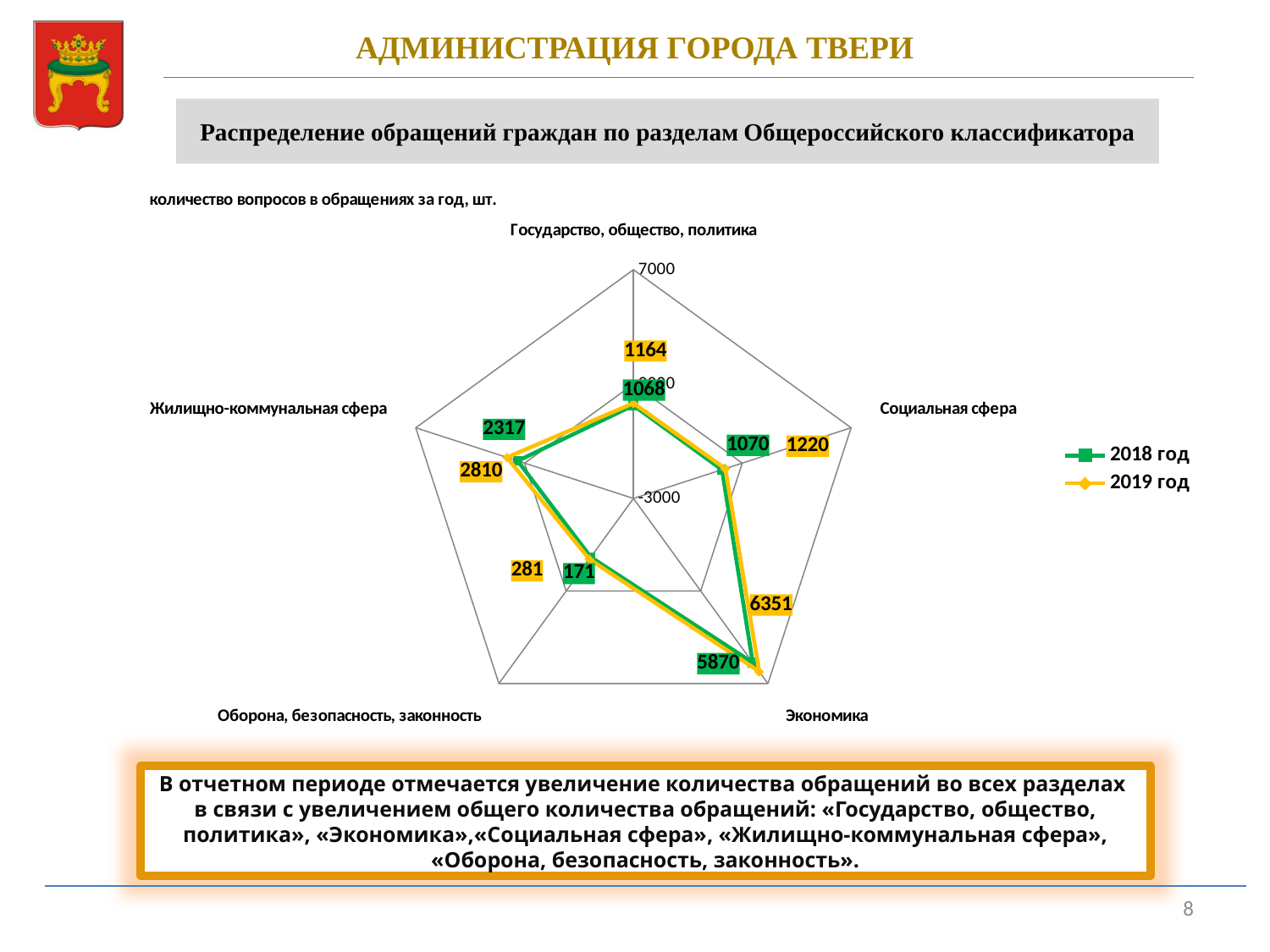
What is the value for Оборона, безопасность, законность in 2019 год? 281 What kind of chart is shown on the slide? Radar chart Which is larger for Государство, общество, политика: the 2018 год value or the 2019 год value? 2019 год What is the value for Жилищно-коммунальная сфера in 2018 год? 2317 What is the value for Экономика in 2019 год? 6351 How many series does the legend list? 2 What is the value for Социальная сфера in 2018 год? 1070 What is the difference between the 2019 год and 2018 год values for Экономика? 481 Which category has the lowest value in 2018 год? Оборона, безопасность, законность Which series is drawn in yellow in the legend? 2019 год How many categories (axes) does the radar chart have? 5 Which category has the highest value in 2019 год? Экономика